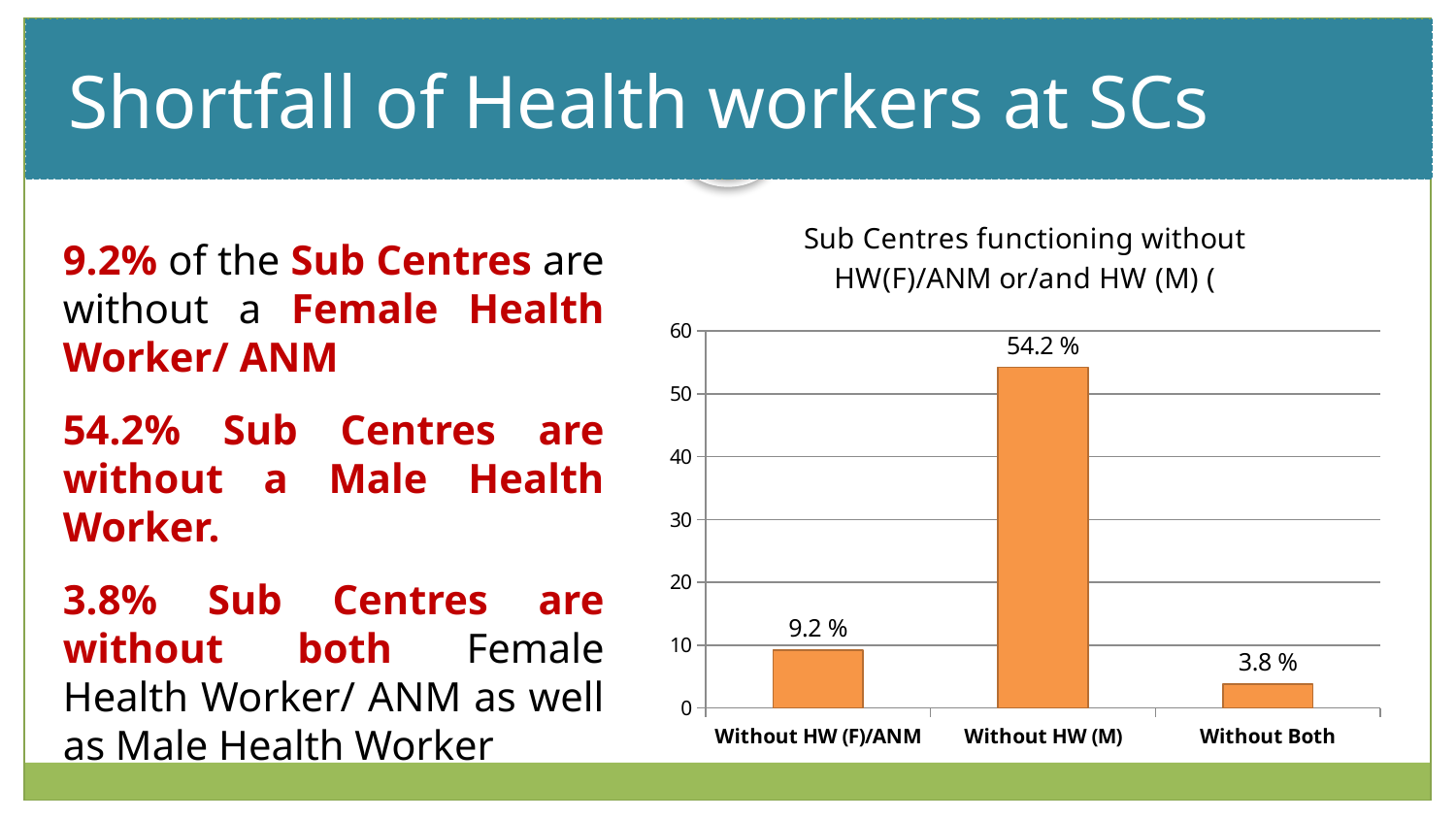
What is the title of the chart? Sub Centres functioning without HW(F)/ANM or/and HW (M) ( What is the value for Without HW (F)/ANM? 9.2 % What is the difference between the values for Without HW (F)/ANM and Without Both? 5.4 % How many categories are shown on the chart? 3 Is the value for Without HW (M) greater or less than 50? greater Which is larger, the value for Without HW (F)/ANM or the value for Without Both? Without HW (F)/ANM What kind of chart is shown on the slide? bar chart Which category has the lowest value? Without Both What is the value for Without HW (M)? 54.2 % What is the value for Without Both? 3.8 % Which category has the highest value? Without HW (M) What is the difference between the values for Without HW (M) and Without HW (F)/ANM? 45 %